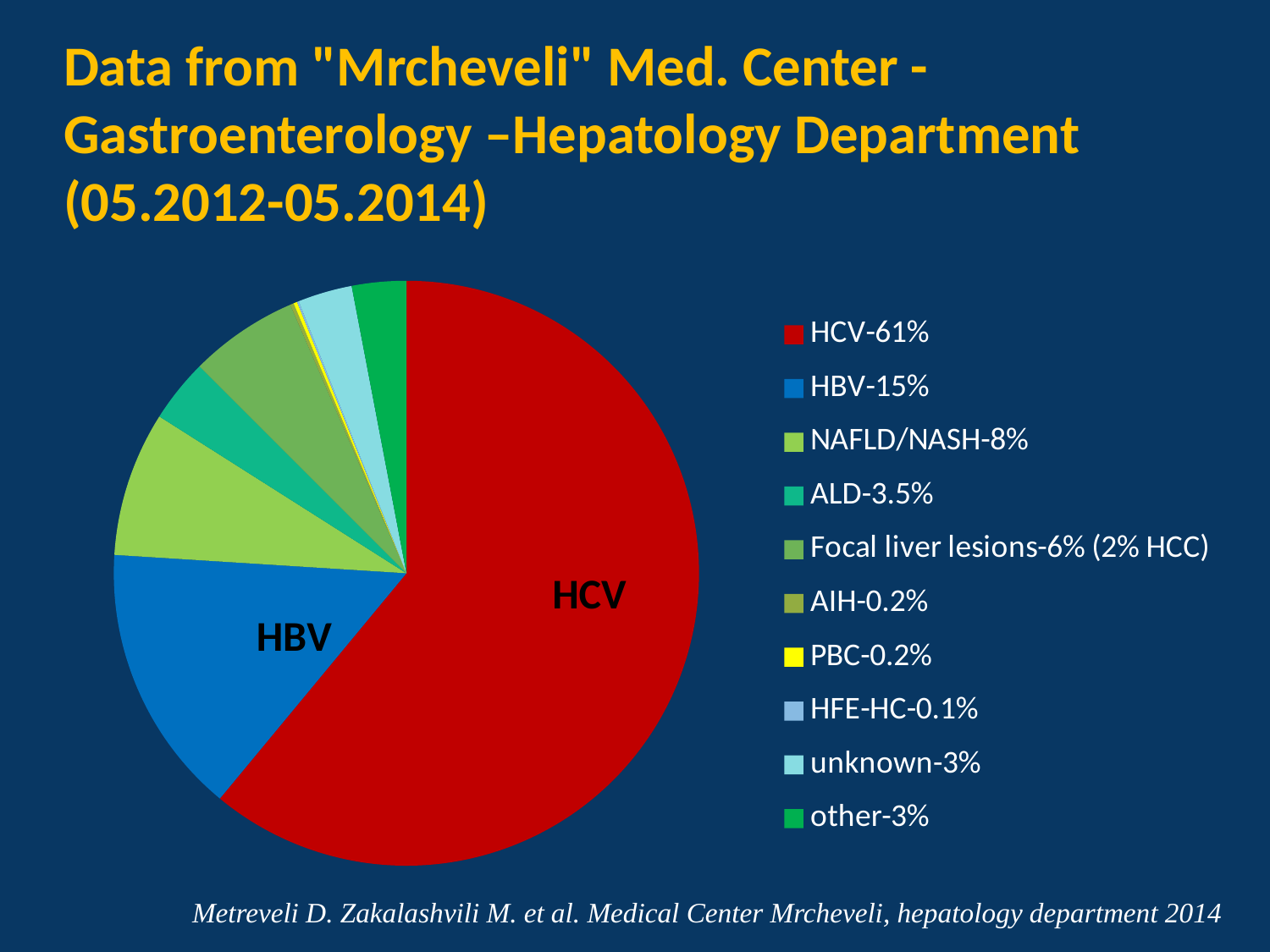
Which is larger, the share for NAFLD/NASH or the share for Focal liver lesions? NAFLD/NASH What is the difference between the HCV share and the HBV share? 46% Which category has the largest share of the pie? HCV Which two pie slices are labelled directly on the pie itself? HCV and HBV Which category has the smallest share of the pie? HFE-HC What is the value shown for Focal liver lesions? 6% (2% HCC) How many categories does the pie chart's legend list? 10 What is the value shown for ALD? 3.5% What is the value shown for NAFLD/NASH? 8% What is the value shown for HBV in the legend? 15% What kind of chart is shown on the slide? pie chart What share of the pie does HCV account for? 61%